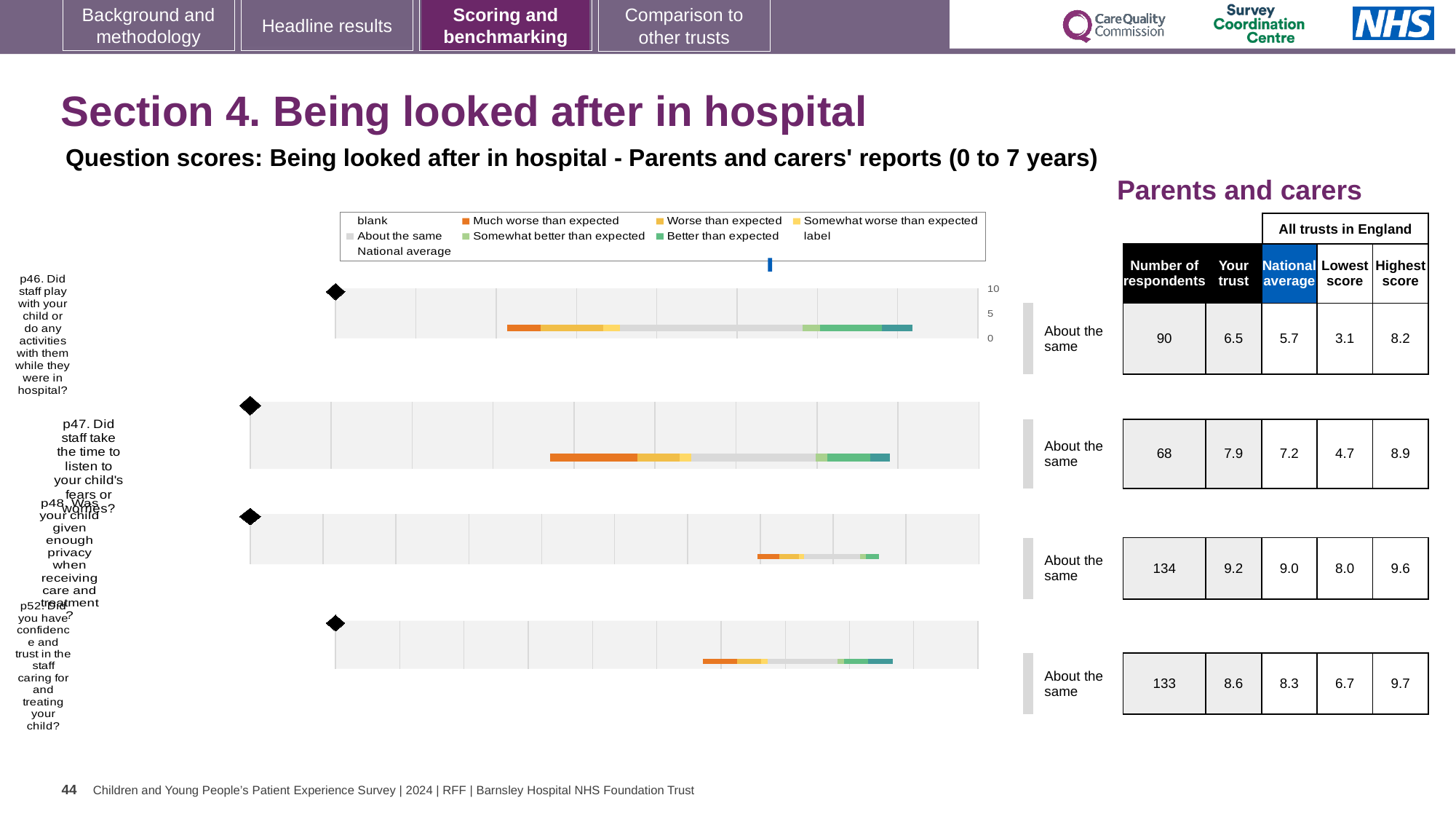
In the table, what is the difference between the 'Your trust' score and the national average for p46? 0.8 In the chart legend, which category is shown in orange? Much worse than expected In the table, which question has the highest 'Your trust' score? p48 In the table, is the 'Your trust' score for p52 higher or lower than the national average for p52? higher How many questions (bars) are plotted in the chart area on this slide? 4 What kind of chart is used to show the question scores on this slide? bar chart How many entries does the chart legend list? 9 In the table, what is the 'Your trust' score for p46 (Did staff play with your child or do any activities with them while they were in hospital?)? 6.5 In the table, what is the national average for p47 (Did staff take the time to listen to your child's fears or worries?)? 7.2 In the table, which question has the lowest 'Your trust' score? p46 In the chart legend, which category is shown in dark green? Better than expected In the table, how many respondents answered p48 (Was your child given enough privacy when receiving care and treatment?)? 134